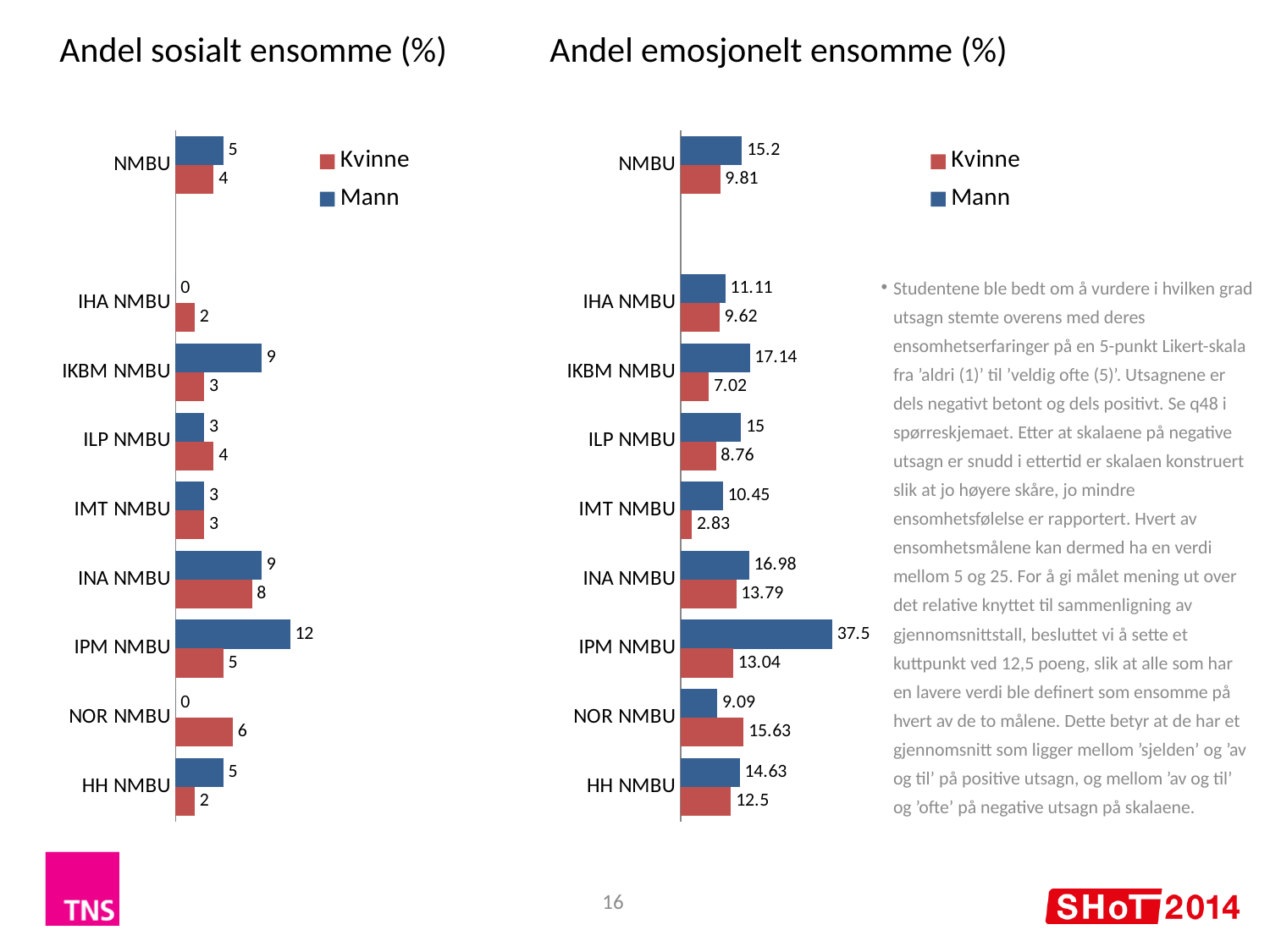
In the 'Andel emosjonelt ensomme (%)' chart, which category has the lowest Kvinne value? IMT NMBU In the 'Andel sosialt ensomme (%)' chart, what is the value for Kvinne at NOR NMBU? 6 In the 'Andel emosjonelt ensomme (%)' chart, which category has the highest Mann value? IPM NMBU In the 'Andel sosialt ensomme (%)' chart, what is the difference between the Mann and Kvinne values at IKBM NMBU? 6 In the 'Andel sosialt ensomme (%)' chart, what is the value for Mann at IPM NMBU? 12 In the 'Andel emosjonelt ensomme (%)' chart, what is the value for Kvinne at IMT NMBU? 2.83 In the 'Andel emosjonelt ensomme (%)' chart, what is the value for Mann at IKBM NMBU? 17.14 In the 'Andel emosjonelt ensomme (%)' chart, what is the difference between the Mann and Kvinne values at NMBU? 5.39 How many categories are shown in the 'Andel sosialt ensomme (%)' chart? 9 What type of chart is 'Andel emosjonelt ensomme (%)'? Bar chart In the 'Andel sosialt ensomme (%)' chart, which category has the highest Mann value? IPM NMBU In the 'Andel emosjonelt ensomme (%)' chart, is the Kvinne value or the Mann value larger at NOR NMBU? Kvinne